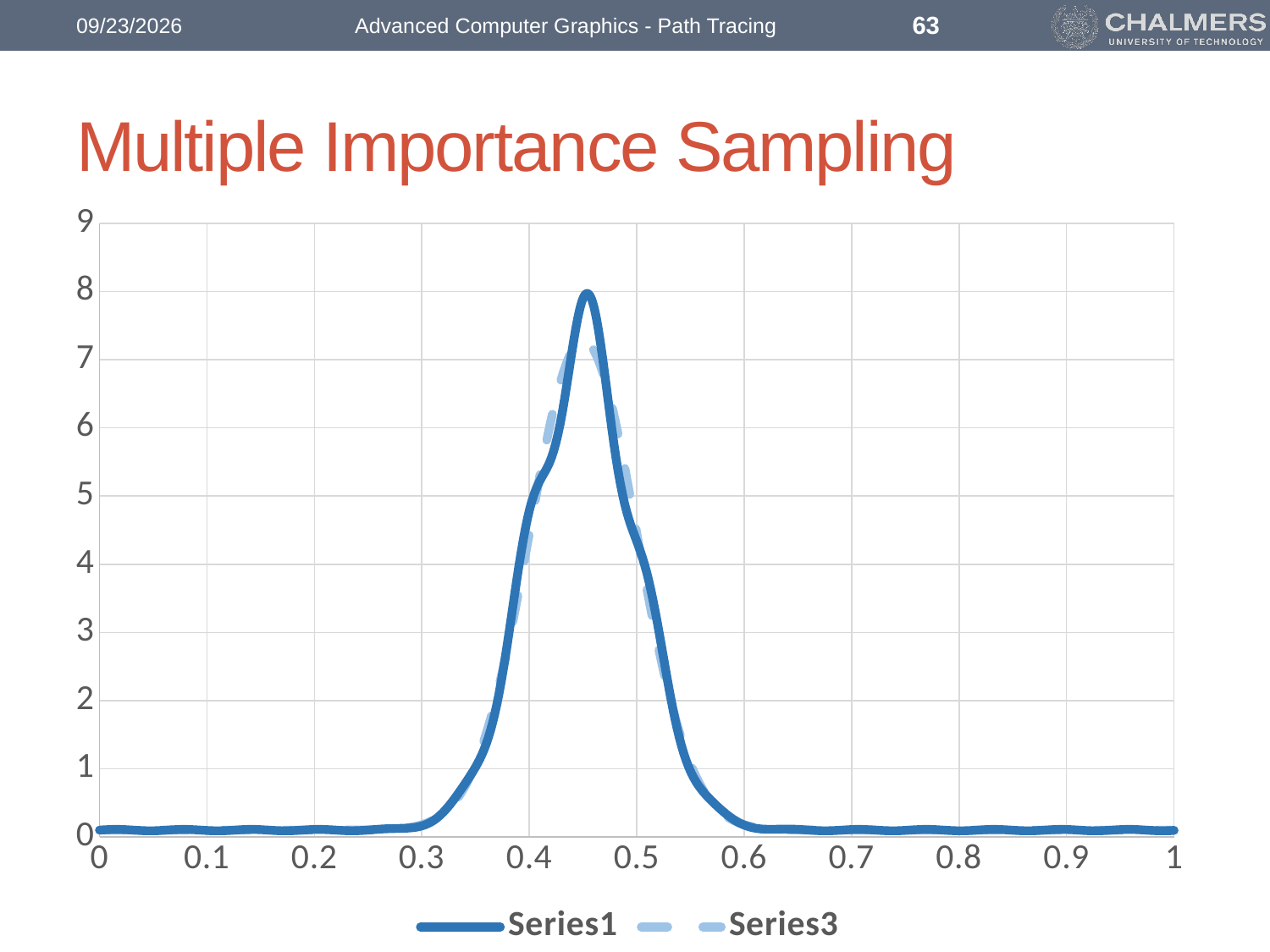
Is the value of Series1 at x = 0.4 greater or less than 3? greater Is the value of Series1 at x = 0.3 greater or less than 1? less How many series does the legend list? 2 Between which two x-axis ticks does Series1 reach its maximum? 0.4 and 0.5 Is the peak value of Series1 greater or less than 7? greater What are the names of the series in the legend? Series1 and Series3 What kind of chart is shown on the slide? line chart Which series reaches the higher peak, Series1 or Series3? Series1 What is the title of the slide containing the chart? Multiple Importance Sampling Do the values of Series1 rise or fall as x goes from 0.5 to 0.6? fall